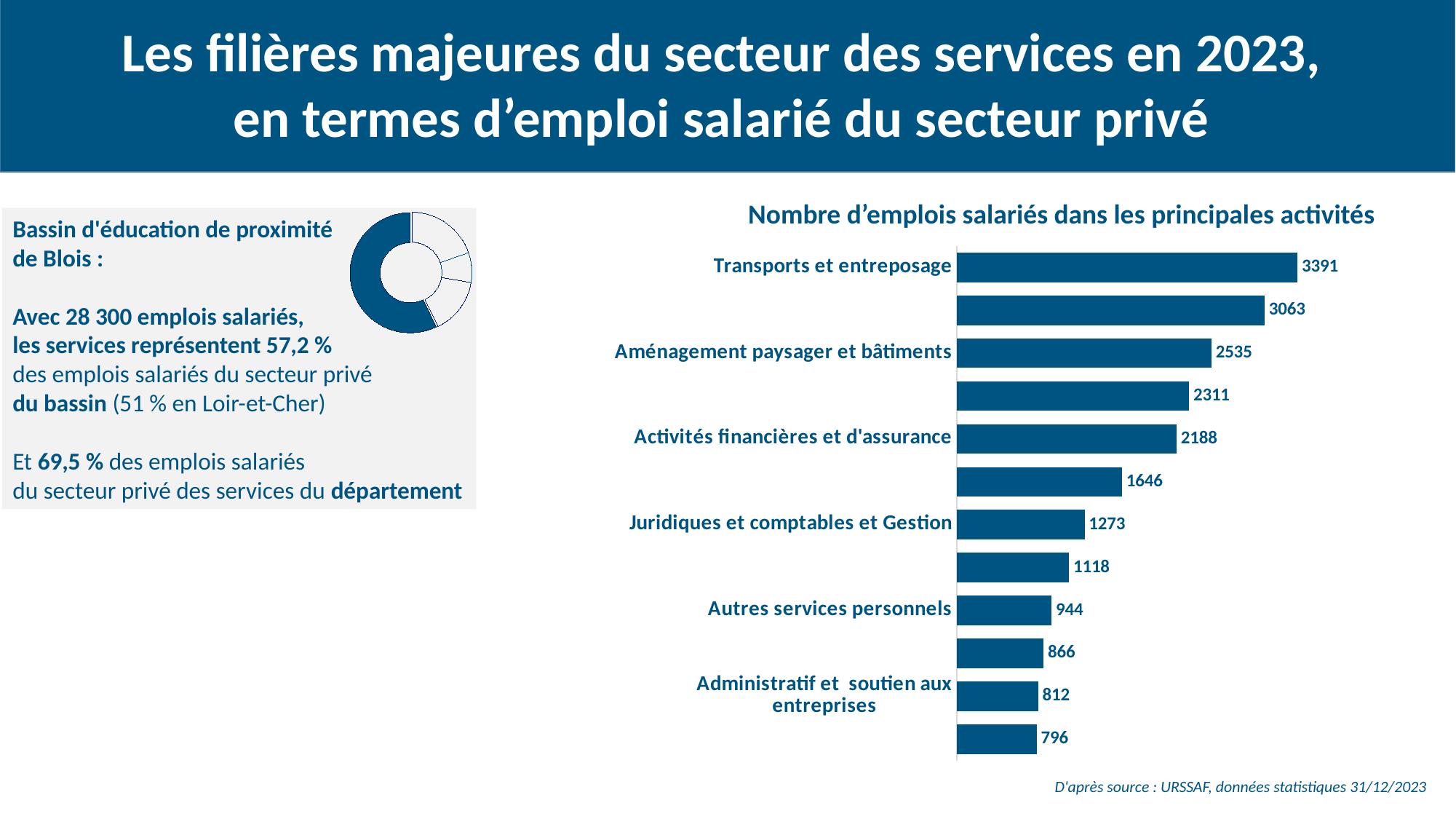
In the bar chart on the right, which is larger: Aménagement paysager et bâtiments or Activités financières et d'assurance? Aménagement paysager et bâtiments In the bar chart on the right, what is the value for Aménagement paysager et bâtiments? 2535 In the bar chart on the right, what is the value for Activités financières et d'assurance? 2188 In the bar chart on the right, what is the value for Juridiques et comptables et Gestion? 1273 In the bar chart on the right, what is the smallest value shown on any bar? 796 What type of chart is shown on the right side of the slide? Bar chart In the bar chart on the right, what is the difference between Transports et entreposage and Aménagement paysager et bâtiments? 856 How many bars are plotted in the bar chart on the right? 12 In the bar chart on the right, what is the difference between Autres services personnels and Administratif et soutien aux entreprises? 132 In the bar chart on the right, what is the value for Administratif et soutien aux entreprises? 812 In the bar chart 'Nombre d'emplois salariés dans les principales activités', what is the value for Transports et entreposage? 3391 In the bar chart on the right, which labelled activity has the highest number of salaried jobs? Transports et entreposage